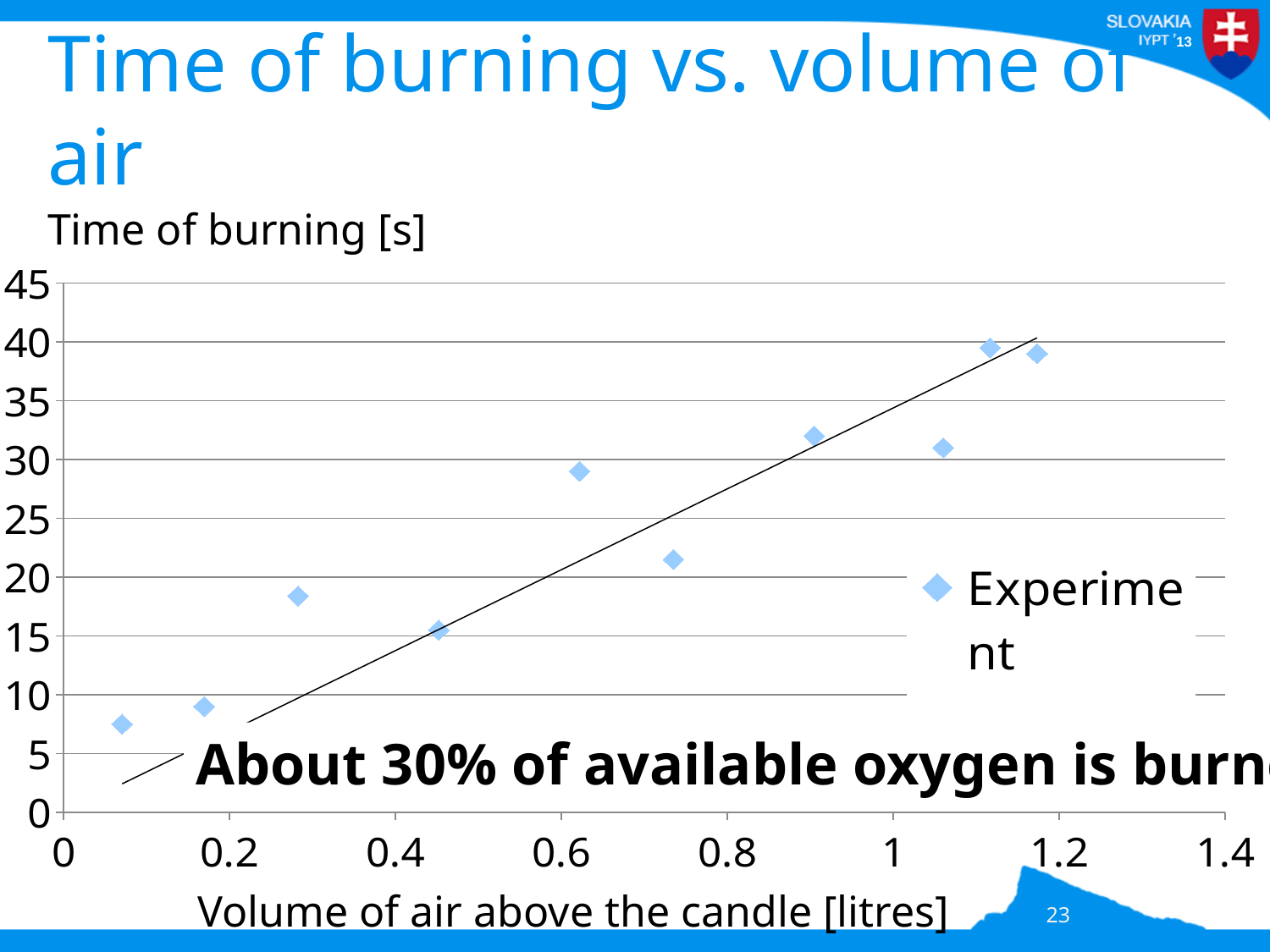
Is the time of burning for the point at about 0.45 litres greater or less than 20? less Is the time of burning for the point at about 0.9 litres greater or less than 30? greater Is the time of burning for the point at about 0.3 litres greater or less than 15? greater What is the name of the series shown in the legend? Experiment Which has the longer time of burning: the point at about 0.6 litres or the point at about 0.75 litres? the point at about 0.6 litres How many series does the legend list? 1 Overall, does the time of burning rise or fall as the volume of air increases? rise What kind of chart is shown on the slide? scatter chart How many data points are plotted in the Experiment series? 10 What is the label of the x axis? Volume of air above the candle [litres]